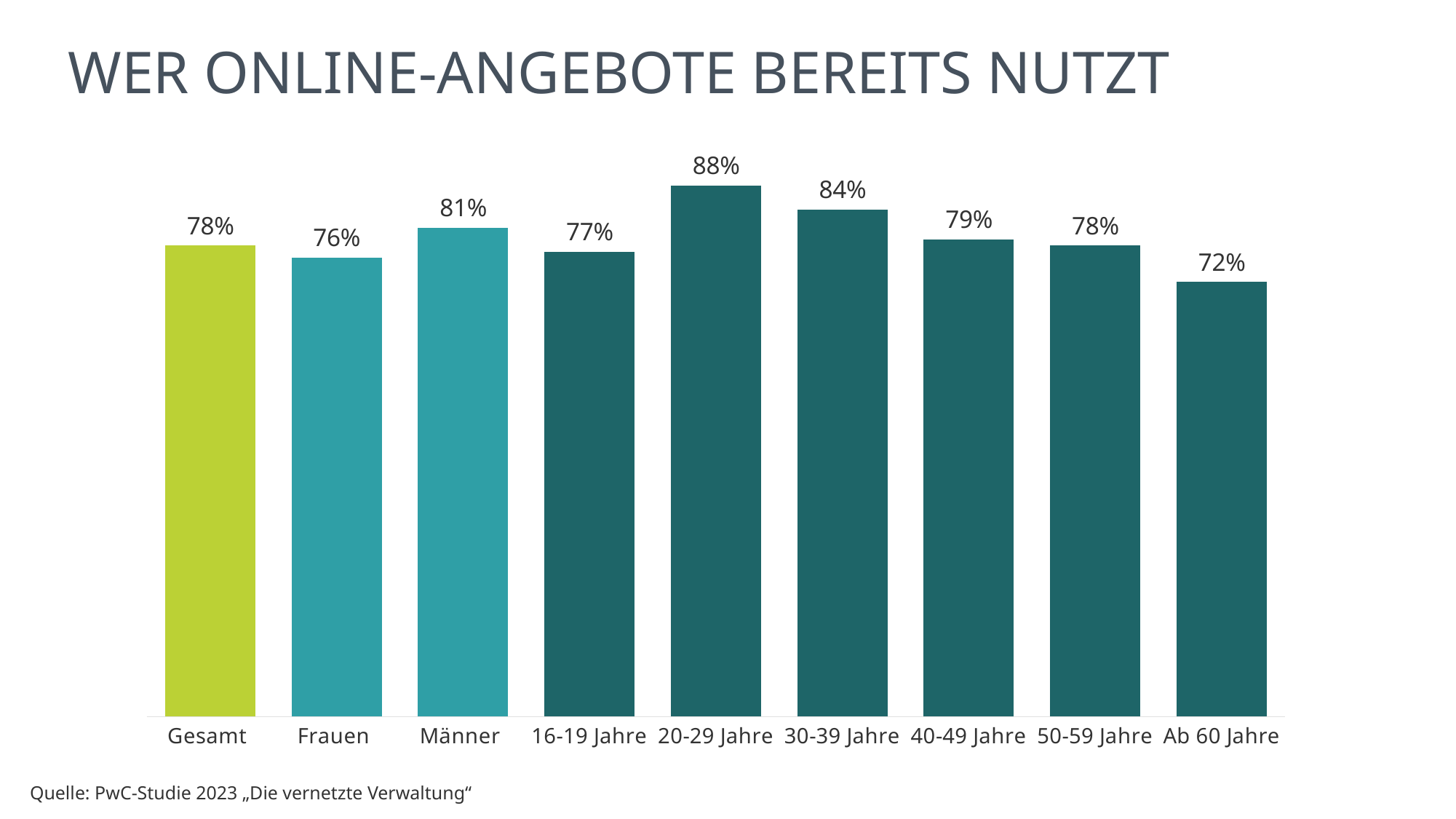
Which is larger, the value for 40-49 Jahre or the value for 16-19 Jahre? 40-49 Jahre What is the value for 30-39 Jahre? 84% What is the value for Ab 60 Jahre? 72% Which category has the lowest value? Ab 60 Jahre How many categories are shown in the chart? 9 What is the value for Männer? 81% Which category has the highest value? 20-29 Jahre What kind of chart is shown on the slide? Bar chart What is the difference between the values for 20-29 Jahre and Ab 60 Jahre? 16% What is the title of the slide? WER ONLINE-ANGEBOTE BEREITS NUTZT What is the difference between the values for Männer and Frauen? 5% What is the value for Gesamt? 78%